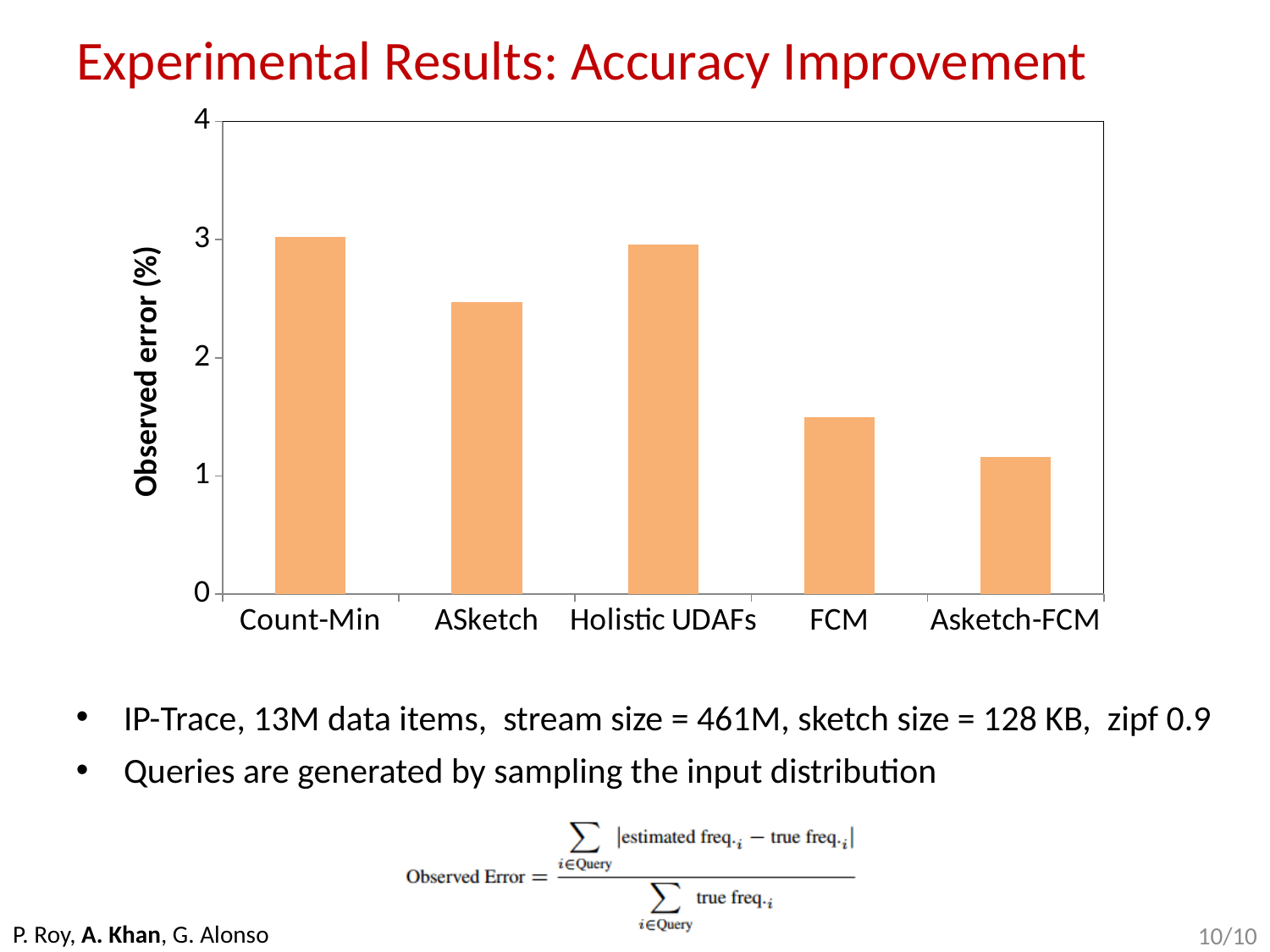
Which has a higher observed error, ASketch or FCM? ASketch Is the observed error for FCM greater or less than 2? less What colour are the bars in the chart? orange How many categories are plotted on the x axis of the chart? 5 What is the label of the y axis of the chart? Observed error (%) Is the observed error for FCM greater or less than 1? greater Which has a higher observed error, Holistic UDAFs or Asketch-FCM? Holistic UDAFs What kind of chart is shown on the slide? bar chart Is the observed error for Asketch-FCM greater or less than 2? less Which category has the lowest observed error in the chart? Asketch-FCM